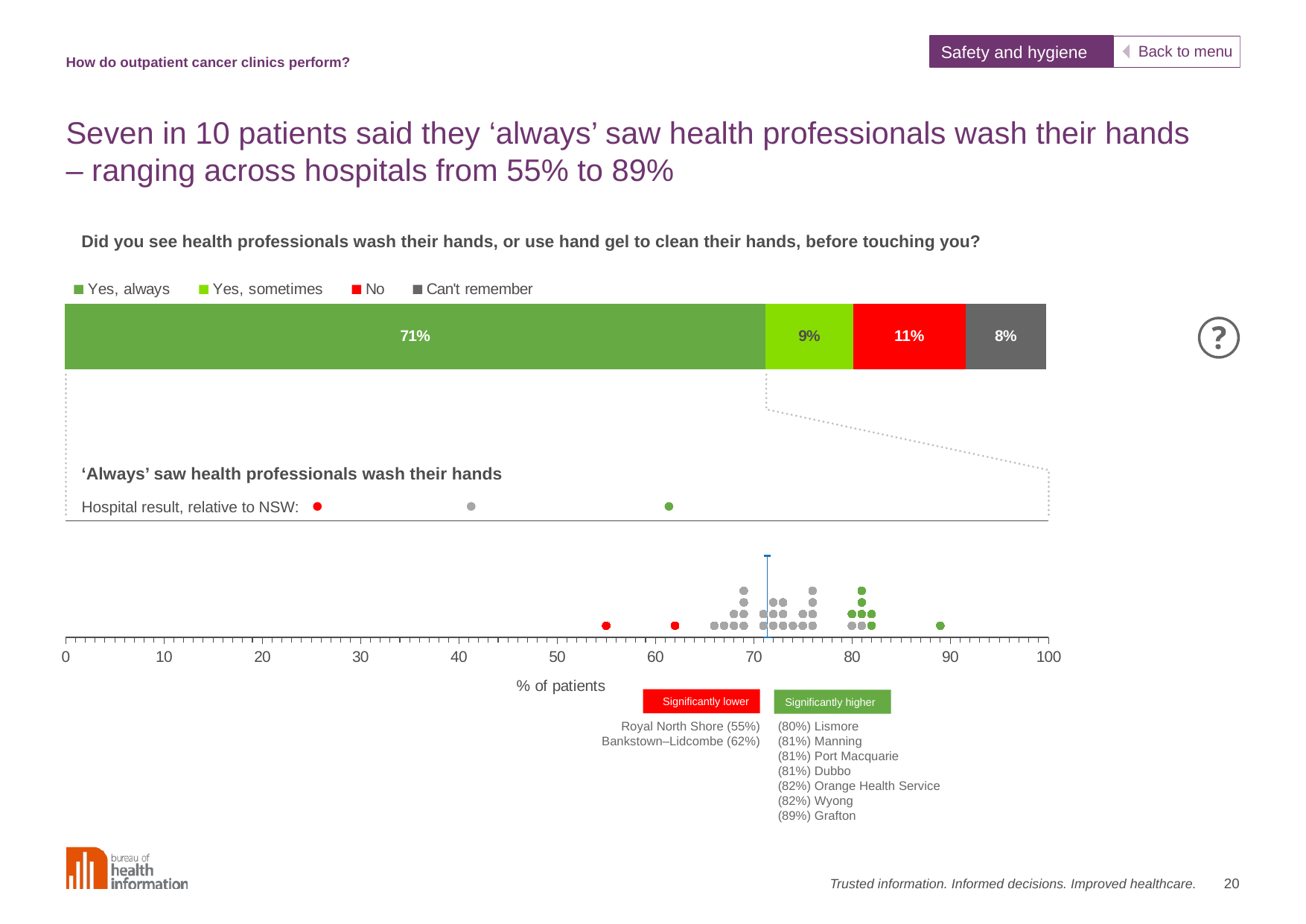
In the hospital dot plot, what is the result for Grafton? 89% In the stacked bar chart, which response category has the smallest share? Can't remember In the hospital dot plot, how many hospitals are listed as significantly higher than NSW? 7 In the stacked bar chart, what percentage of patients answered 'Yes, always'? 71% In the stacked bar chart, what percentage of patients answered 'Can't remember'? 8% In the hospital dot plot, what is the result for Royal North Shore? 55% In the stacked bar chart, what is the difference between the 'No' share and the 'Yes, sometimes' share? 2% How many response categories does the legend of the stacked bar chart list? 4 What kind of chart is the top chart on the slide? Stacked bar chart In the stacked bar chart, what percentage of patients answered 'No'? 11% In the stacked bar chart, which response category has the largest share? Yes, always In the stacked bar chart, which is larger: the 'No' share or the 'Can't remember' share? No